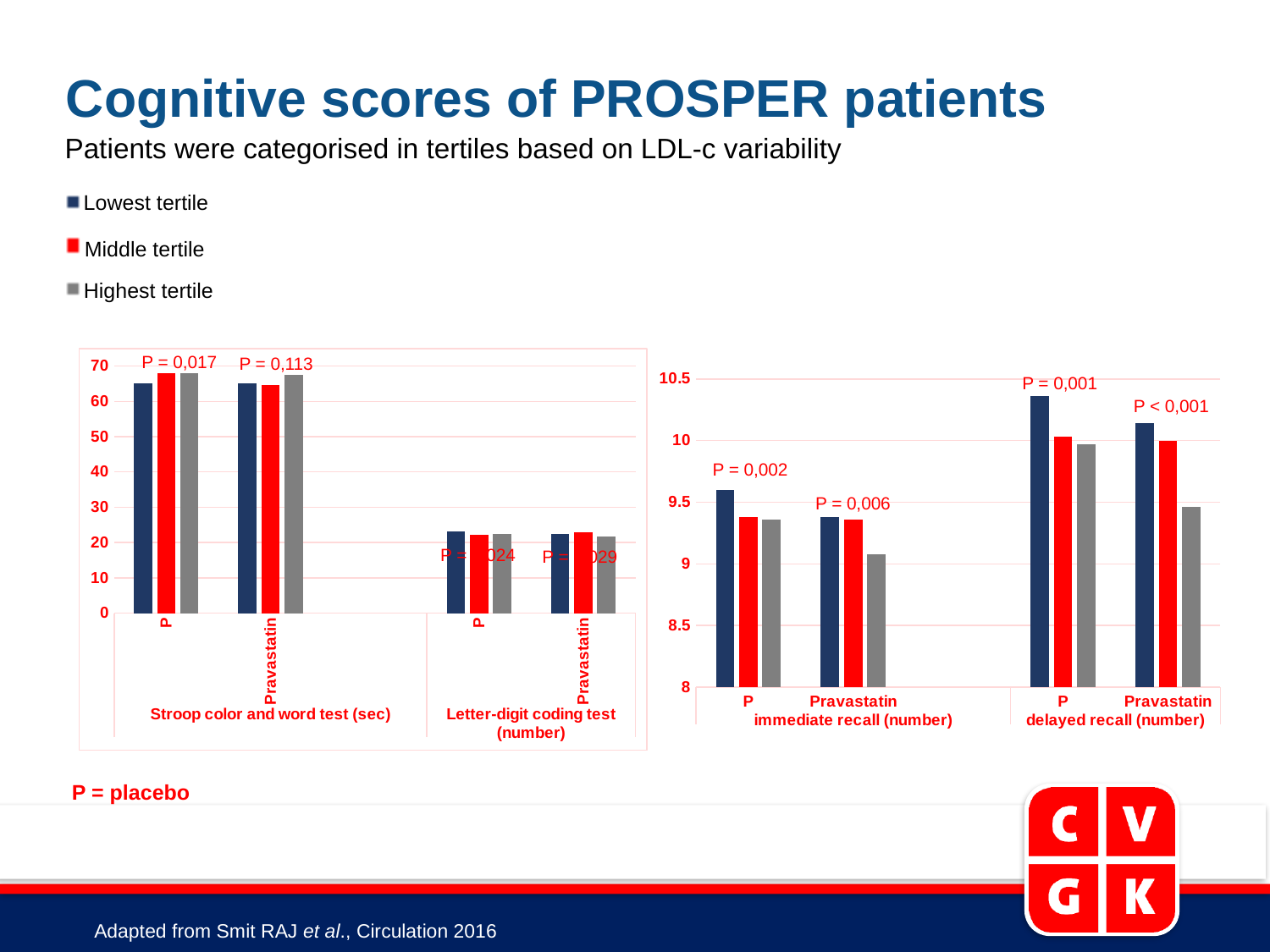
In the right chart, is the delayed recall value for the placebo (P) lowest tertile greater or less than 10? greater In the left chart, is the Letter-digit coding test value for the placebo (P) lowest tertile greater or less than 30? less In the left chart, is the Stroop color and word test value for the placebo (P) lowest tertile greater or less than 60? greater What kind of chart is the left chart (Stroop color and word test / Letter-digit coding test)? bar chart In the right chart, what P-value is annotated above the delayed recall Pravastatin bars? P < 0,001 In the left chart, for the Stroop color and word test with placebo (P), which is larger: the lowest tertile or the middle tertile? Middle tertile How many test categories are shown on the x axis of the right chart? 2 In the right chart, for delayed recall with Pravastatin, which is larger: the lowest tertile or the highest tertile? Lowest tertile In the right chart, for delayed recall with placebo (P), which tertile has the highest value? Lowest tertile In the right chart, for delayed recall with Pravastatin, which tertile has the lowest value? Highest tertile How many series does the legend list for the charts? 3